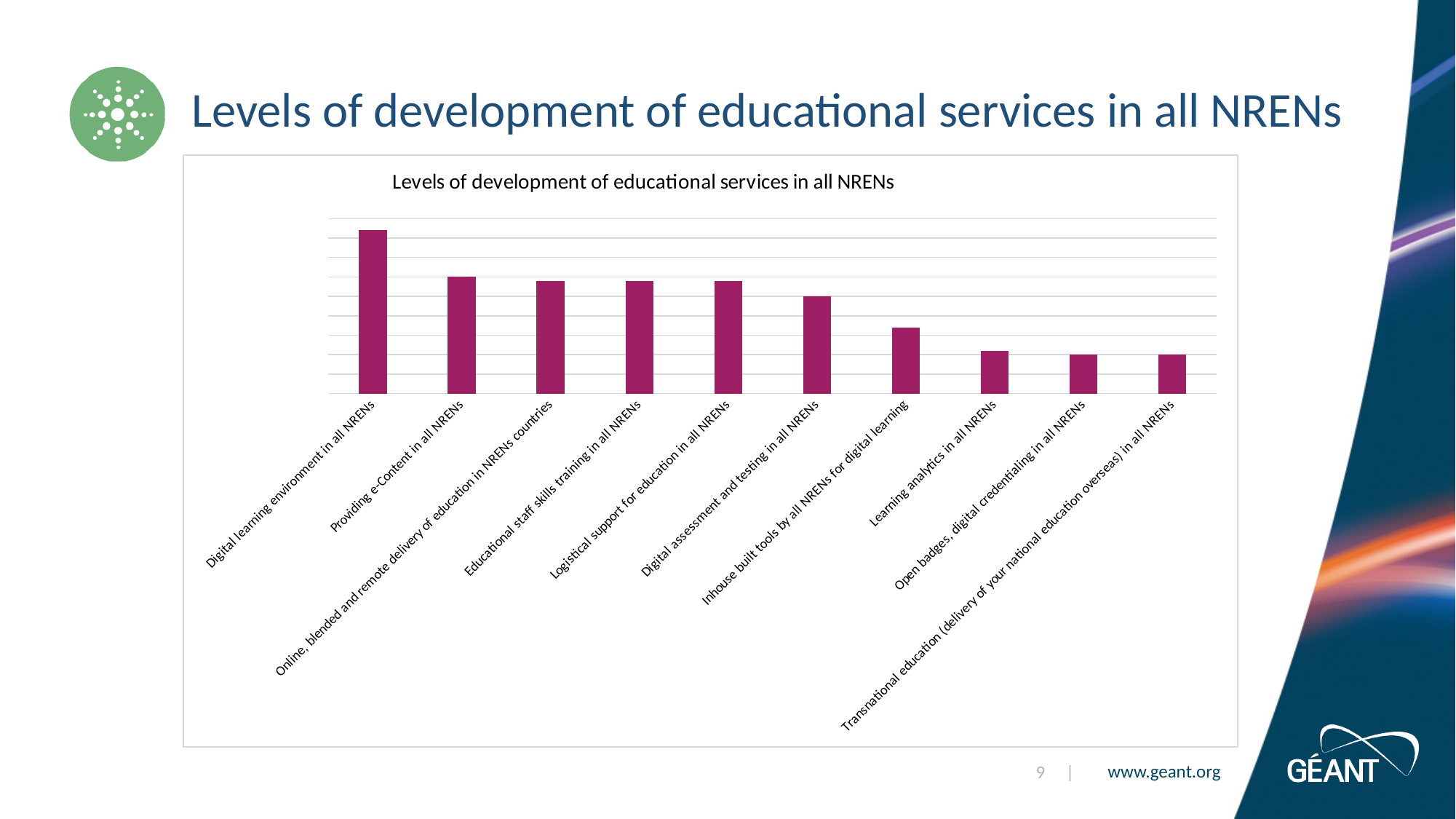
What is the title of the chart? Levels of development of educational services in all NRENs Which is larger: the value for Inhouse built tools by all NRENs for digital learning or the value for Learning analytics in all NRENs? Inhouse built tools by all NRENs for digital learning What kind of chart is shown on the slide? bar chart Which category has the highest bar in the chart? Digital learning environment in all NRENs Which is larger: the value for Digital learning environment in all NRENs or the value for Providing e-Content in all NRENs? Digital learning environment in all NRENs Which is larger: the value for Logistical support for education in all NRENs or the value for Open badges, digital credentialing in all NRENs? Logistical support for education in all NRENs How many categories are plotted in the chart? 10 What colour are the bars in the chart? magenta Do the bar values generally rise or fall from left to right across the chart? fall